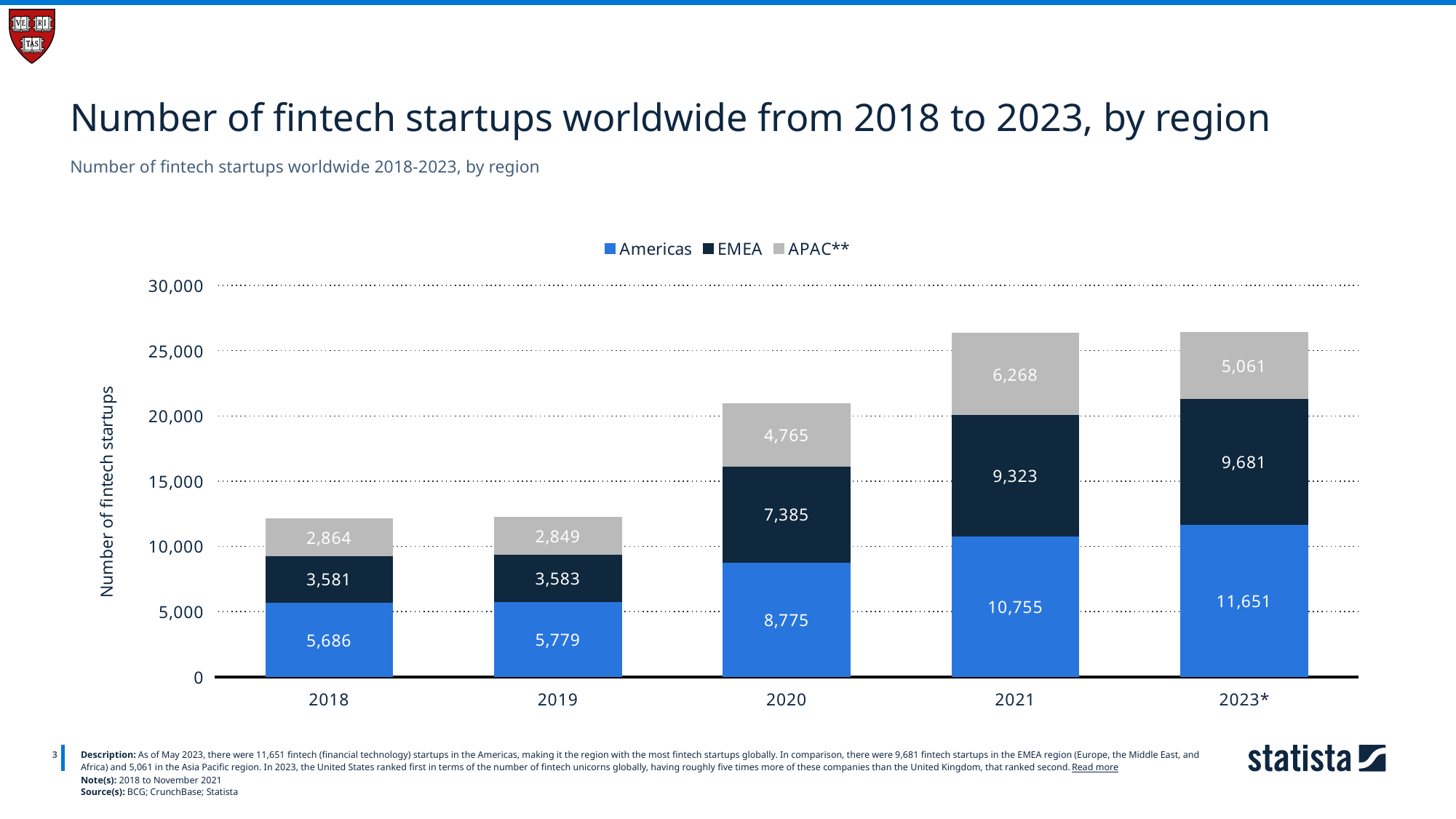
Which is larger, the EMEA value in 2021 or the EMEA value in 2020? 2021 In which year is the Americas value highest? 2023* How many years are shown on the x axis? 5 What is the number of fintech startups in the Americas in 2023*? 11,651 Does the Americas value rise or fall from 2018 to 2023*? Rise In which year is the APAC** value lowest? 2019 What is the EMEA value for 2020? 7,385 What is the difference between the Americas value in 2023* and in 2018? 5,965 How many series does the legend list? 3 What is the APAC** value for 2018? 2,864 What is the total number of fintech startups across all regions in 2020? 20,925 What type of chart is shown on the slide? Stacked bar chart